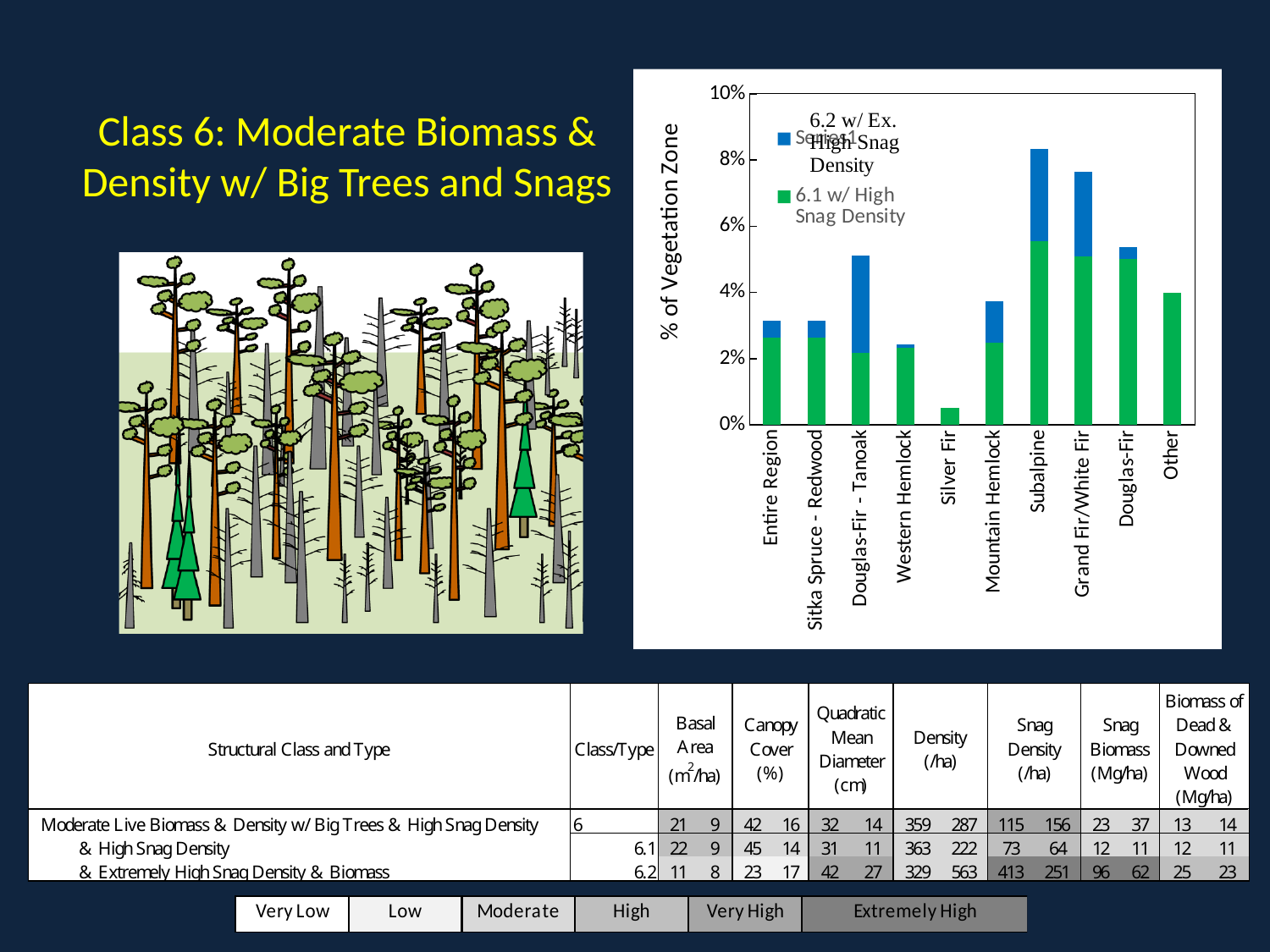
Which vegetation zone has the lowest total bar in the chart? Silver Fir What is the label on the vertical axis of the chart? % of Vegetation Zone Is the total value for Grand Fir/White Fir greater or less than 6%? greater Is the total value for Mountain Hemlock greater or less than 4%? less Is the total value for Douglas-Fir greater or less than 4%? greater Which has a larger total bar, Entire Region or Silver Fir? Entire Region How many vegetation zone categories are shown on the x axis of the chart? 10 Which vegetation zone has the highest total bar in the chart? Subalpine Which has a larger total bar, Subalpine or Grand Fir/White Fir? Subalpine What kind of chart is shown on the slide? bar chart